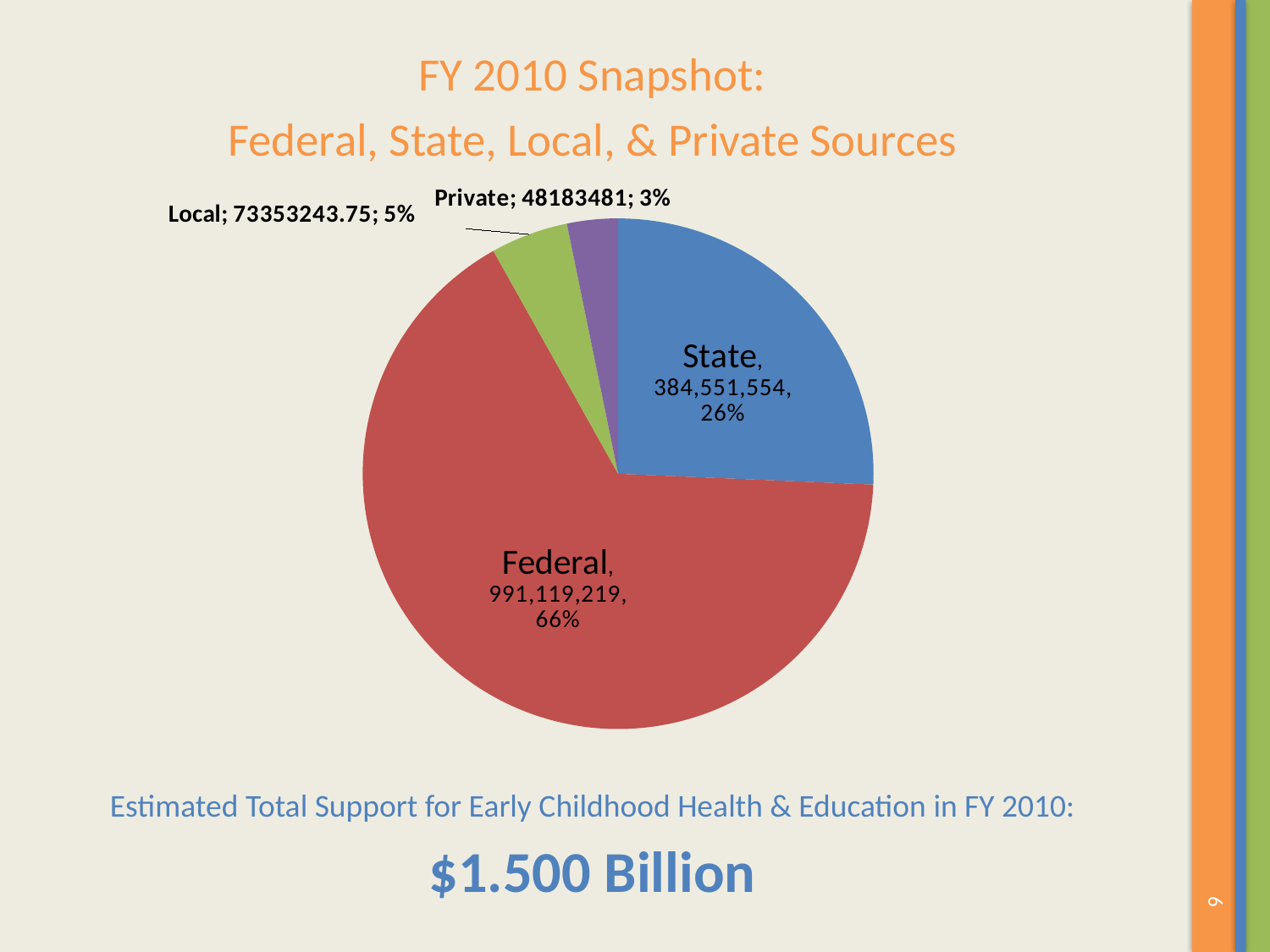
What is the value shown for State? 384,551,554 What percentage share of the pie does Federal represent? 66% How many slices does the pie chart have? 4 Which source has the smallest slice of the pie? Private What is the value shown for Federal? 991,119,219 What type of chart is shown on the slide? pie chart What is the value shown for Local? 73353243.75 Which source has the largest slice of the pie? Federal Which is larger, the State slice or the Local slice? State What percentage share of the pie does Local represent? 5% What is the value shown for Private? 48183481 What percentage share of the pie does State represent? 26%